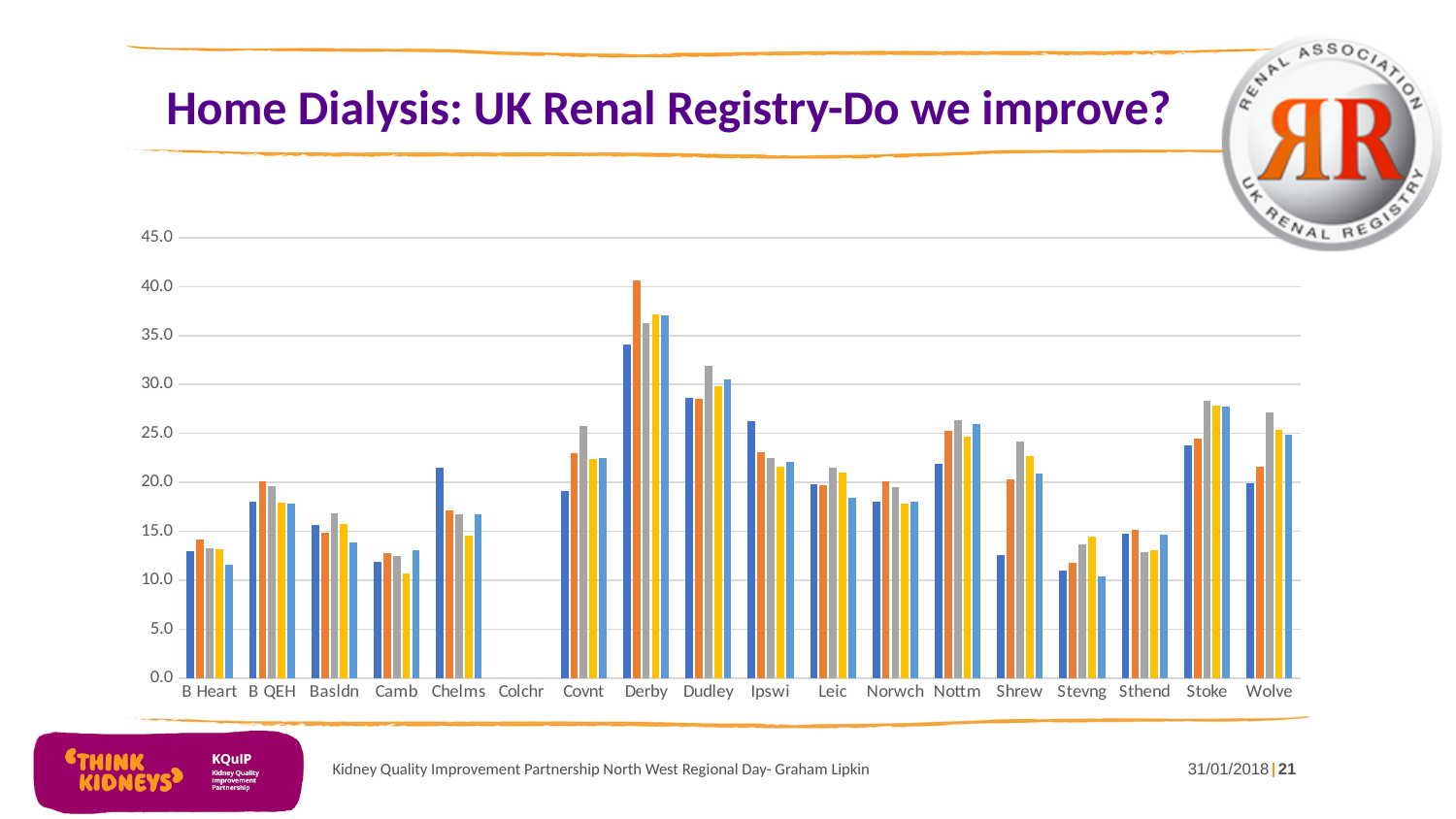
Is the first (blue) bar for Chelms greater or less than 20.0? greater How many categories are labelled along the x axis of the chart? 18 What is the highest value shown on the y axis of the chart? 45.0 Which has the taller first (blue) bar, Derby or Camb? Derby Is the grey bar for Dudley greater or less than 30.0? greater Which category contains the tallest bar in the chart? Derby Which has the taller orange bar, Nottm or Leic? Nottm Is the first (blue) bar for Derby greater or less than 30.0? greater Which category on the x axis has no bars plotted? Colchr What kind of chart is shown on the slide? bar chart